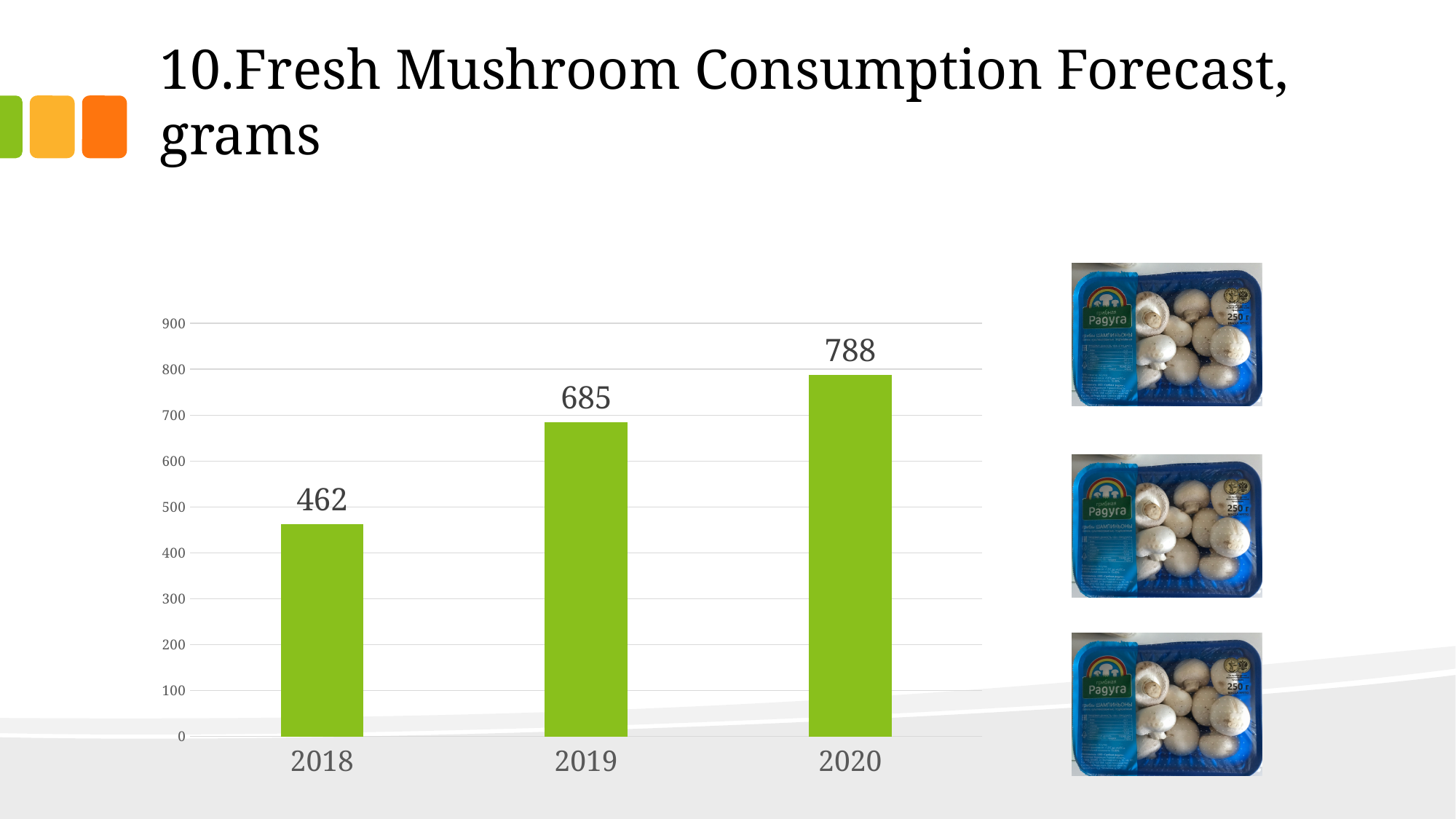
What is the difference between the 2020 and 2018 values? 326 What is the forecast fresh mushroom consumption for 2019? 685 What is the forecast fresh mushroom consumption for 2018? 462 Do the values rise or fall from 2018 to 2020? rise What is the difference between the 2019 and 2018 values? 223 Is the value for 2019 greater or less than 600? greater Which year has the lowest forecast consumption? 2018 Which year has the highest forecast consumption? 2020 What is the forecast fresh mushroom consumption for 2020? 788 Which is larger, the value for 2019 or the value for 2020? 2020 How many years are shown on the chart? 3 What kind of chart is shown on the slide? bar chart